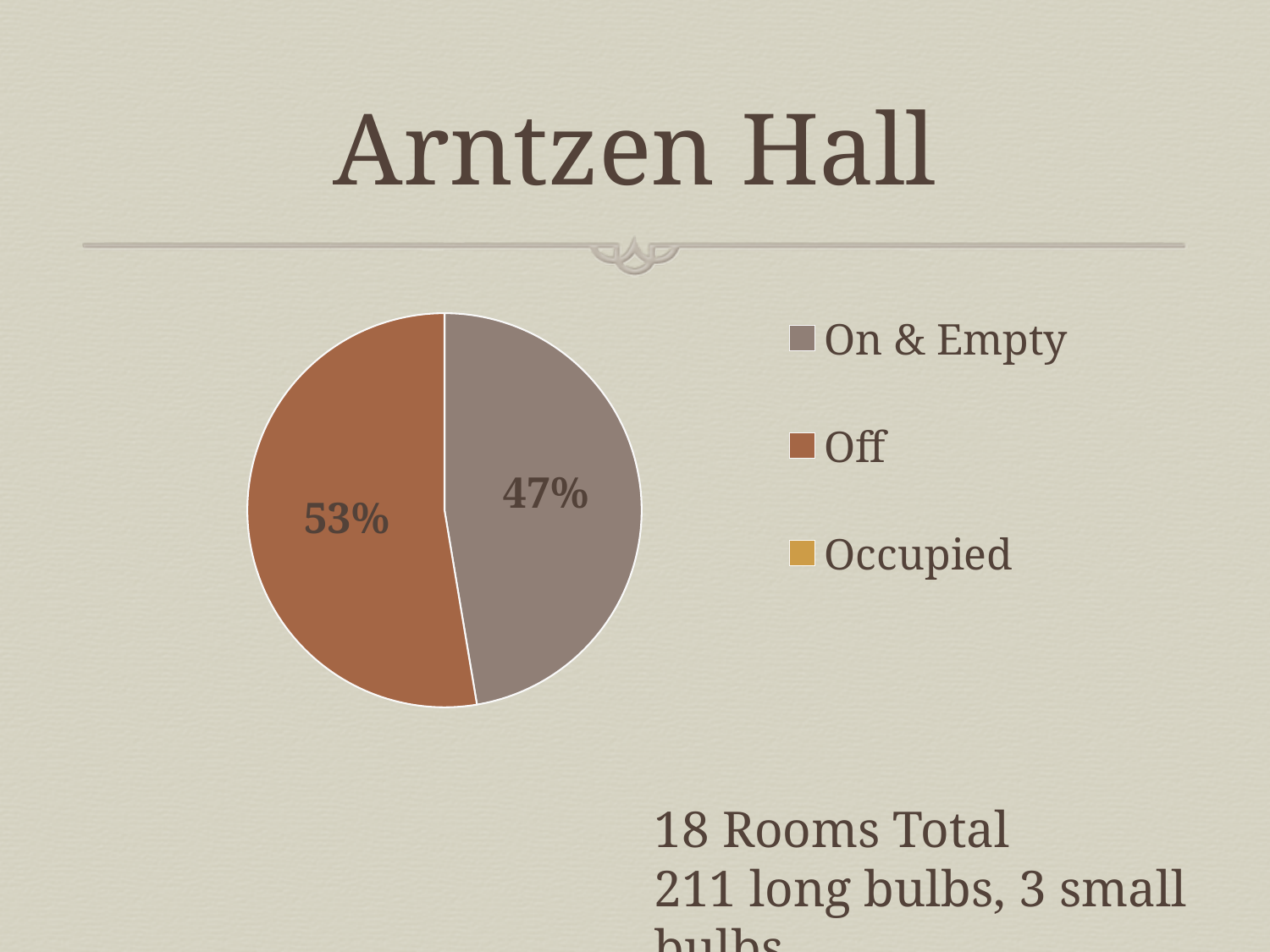
What kind of chart is shown on the slide? pie chart What is the difference in percentage points between the "Off" slice and the "On & Empty" slice? 6 What is the title of the slide containing the pie chart? Arntzen Hall Is the share for "On & Empty" greater or less than 50%? less Which legend entry is shown in brown? Off What share of the pie is labelled "On & Empty"? 47% How many slices of the pie have a percentage label printed on them? 2 What share of the pie is labelled "Off"? 53% Is the share for "Off" greater or less than 50%? greater How many entries does the legend list? 3 Which slice of the pie is the largest? Off Which of the two labelled slices is larger, "Off" or "On & Empty"? Off